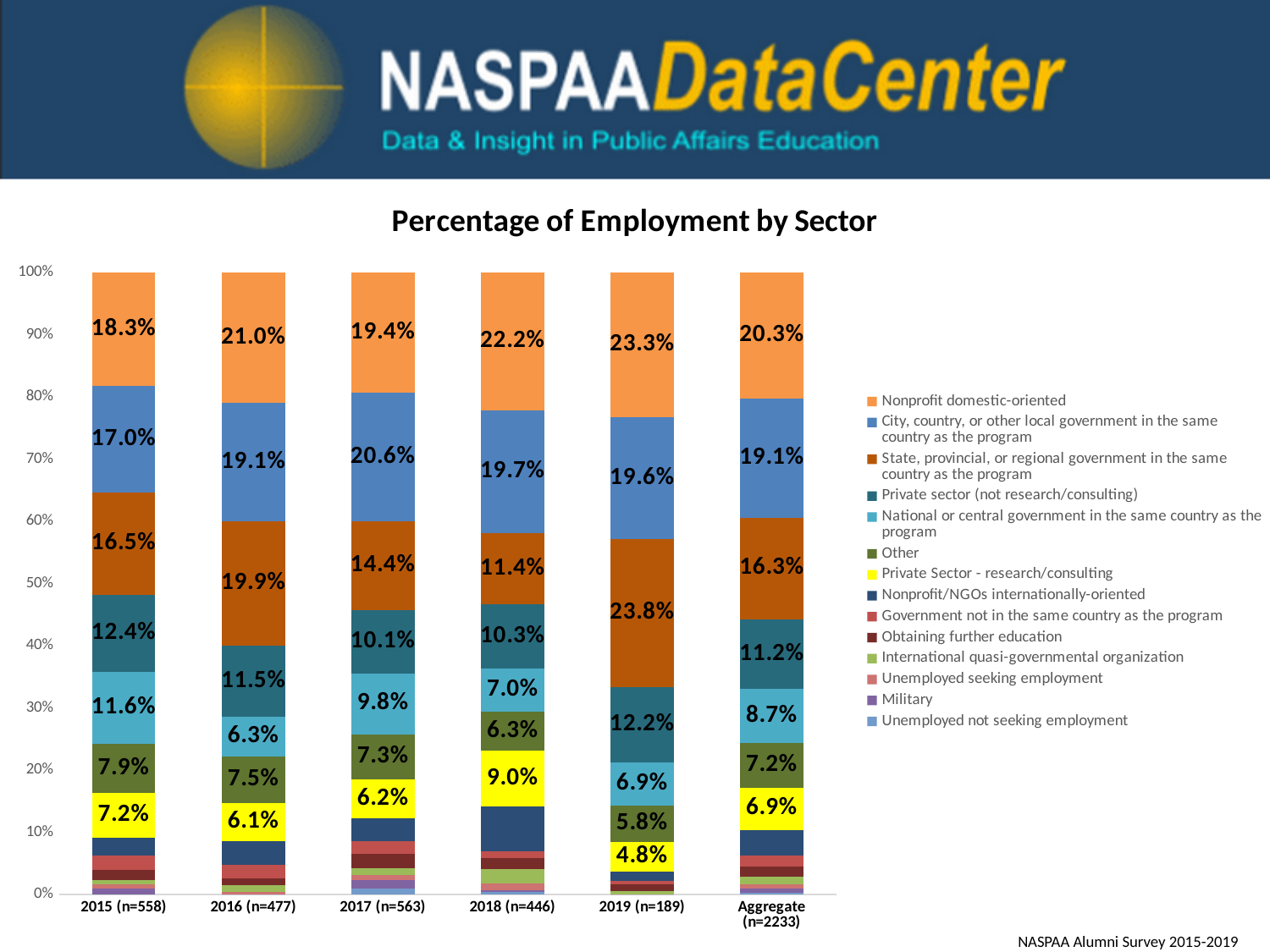
How many series does the legend list? 14 What is the difference between the Nonprofit domestic-oriented values for 2018 (n=446) and 2015 (n=558)? 3.9% What type of chart is shown on the slide? stacked bar chart What is the value for State, provincial, or regional government in the same country as the program in 2018 (n=446)? 11.4% Which is larger: the National or central government value in 2015 (n=558) or in 2017 (n=563)? 2015 (n=558) What is the value for Nonprofit domestic-oriented in 2019 (n=189)? 23.3% How many bars (categories) are plotted along the x axis? 6 Which year has the lowest value for Private Sector - research/consulting? 2019 (n=189) Which year has the highest value for State, provincial, or regional government in the same country as the program? 2019 (n=189) What is the value for Private Sector - research/consulting in the Aggregate (n=2233) bar? 6.9% Does the Nonprofit domestic-oriented value rise or fall from 2017 (n=563) to 2019 (n=189)? rise What is the title of the chart? Percentage of Employment by Sector